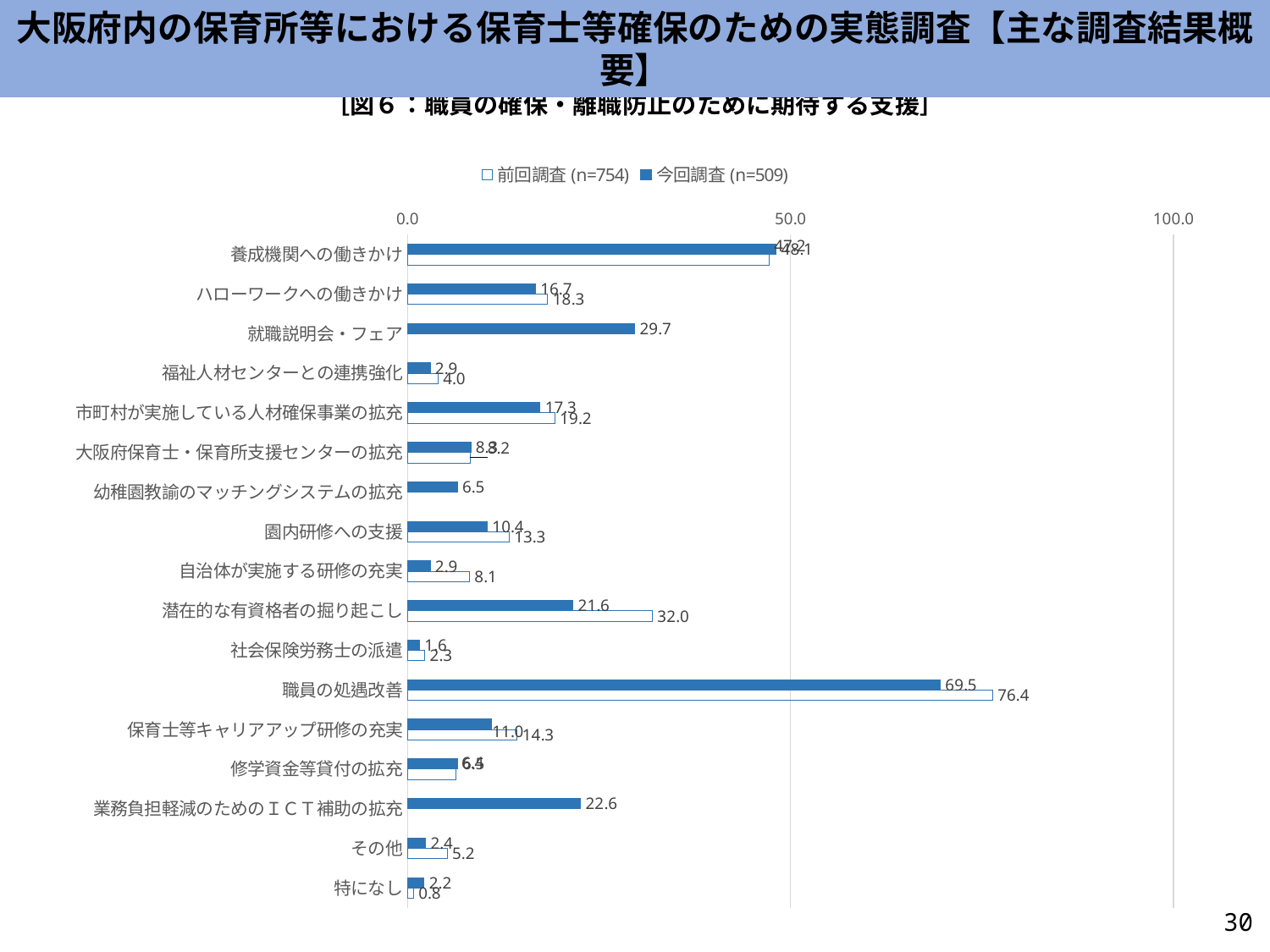
How many categories are plotted on the chart? 17 What is the difference between the 前回調査 and 今回調査 values for 職員の処遇改善? 6.9 What is the value for 特になし in the 前回調査 (n=754) series? 0.8 What is the value for 潜在的な有資格者の掘り起こし in the 前回調査 (n=754) series? 32.0 For 自治体が実施する研修の充実, which series has the larger value, 前回調査 or 今回調査? 前回調査 What is the value for 就職説明会・フェア in the 今回調査 (n=509) series? 29.7 How many series does the legend list? 2 Which category has the highest value for 今回調査 (n=509)? 職員の処遇改善 What kind of chart is shown on the slide? bar chart Is the 今回調査 value for 職員の処遇改善 greater or less than 50.0? greater What is the difference between the 前回調査 and 今回調査 values for 潜在的な有資格者の掘り起こし? 10.4 What is the value for 職員の処遇改善 in the 前回調査 (n=754) series? 76.4